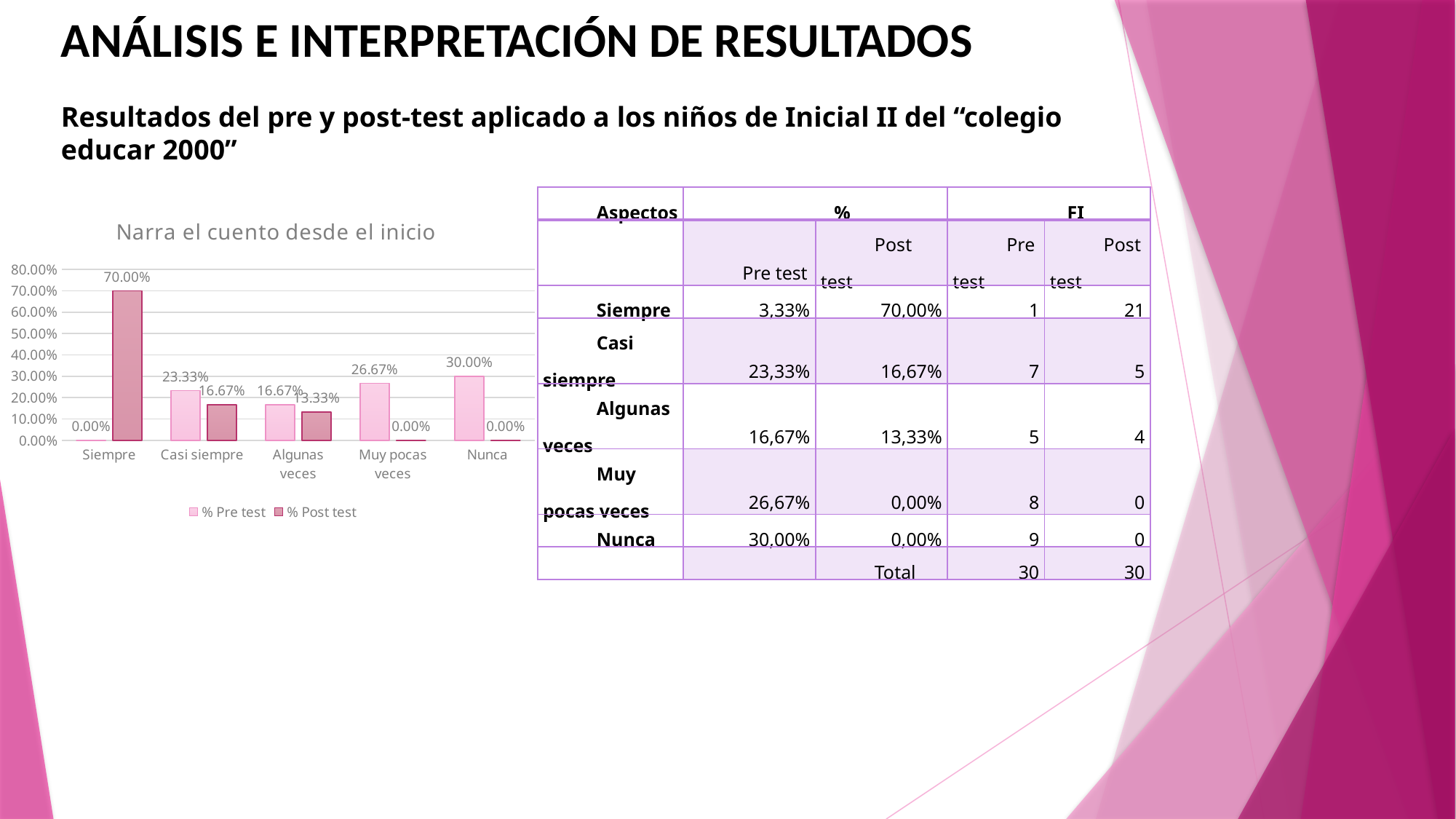
How many categories are shown on the x axis of the chart? 5 Which category has the highest % Post test value? Siempre What is the % Post test value for Siempre? 70.00% What is the % Pre test value for Nunca? 30.00% Which category has the highest % Pre test value? Nunca Which category has the lowest % Pre test value? Siempre How many series does the chart legend list? 2 Which is larger for Algunas veces, the % Pre test value or the % Post test value? % Pre test What is the difference between the % Post test and % Pre test values for Casi siempre? 6.66% What is the % Post test value for Algunas veces? 13.33% What is the % Pre test value for Muy pocas veces? 26.67% What is the title of the chart? Narra el cuento desde el inicio